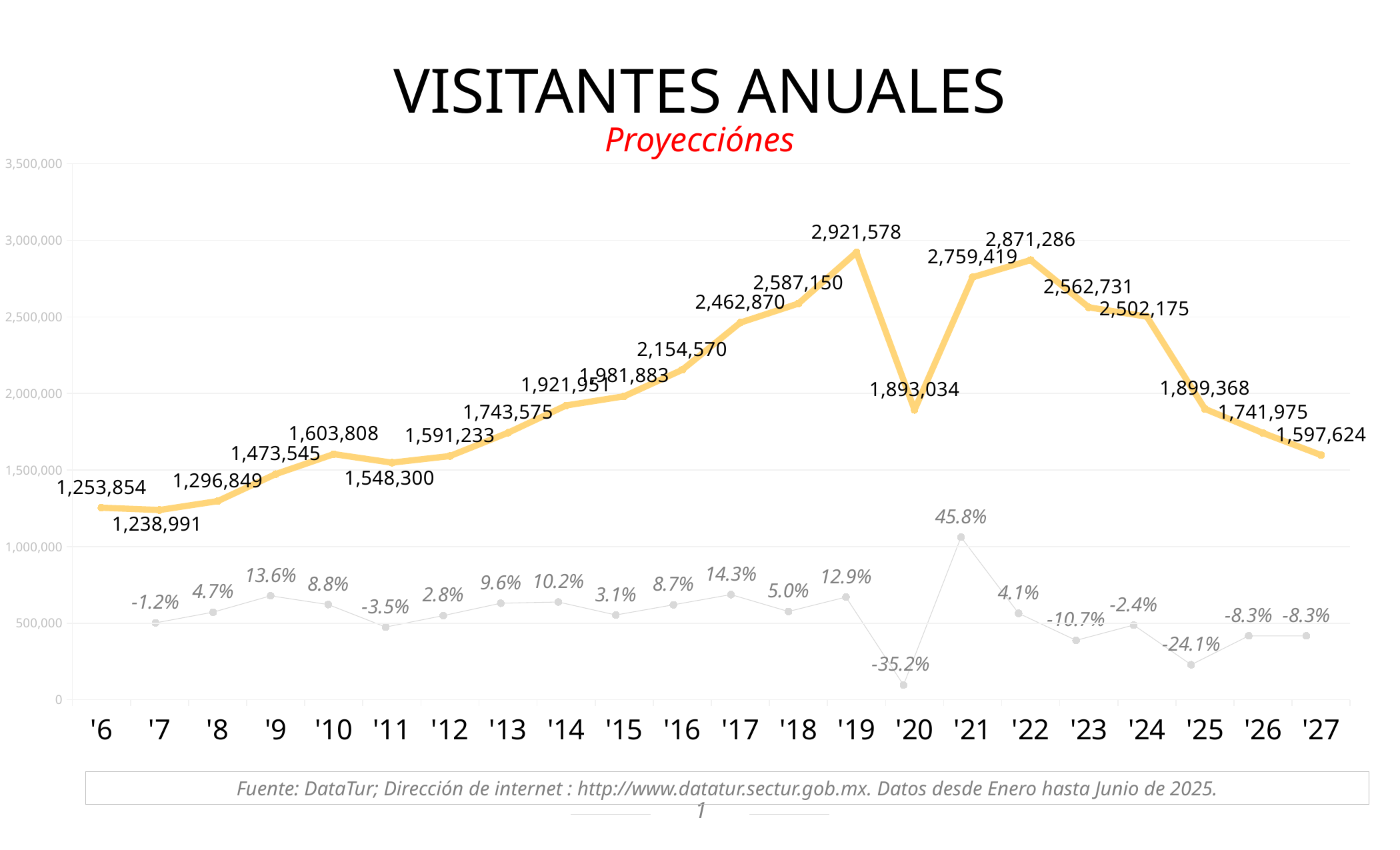
Which year has more annual visitors, '22 or '21? '22 What percentage change is shown for '21? 45.8% What is the projected number of annual visitors for '27? 1,597,624 What is the difference in annual visitors between '19 and '20? 1,028,544 Which year has the highest number of annual visitors? '19 Which year shows the lowest percentage change? '20 What is the number of annual visitors for '20? 1,893,034 What is the subtitle shown in red under the chart title? Proyecciónes What type of chart is shown on the slide? Line chart How many years are plotted on the x axis? 22 Which year has the lowest number of annual visitors? '7 What is the number of annual visitors for '19? 2,921,578